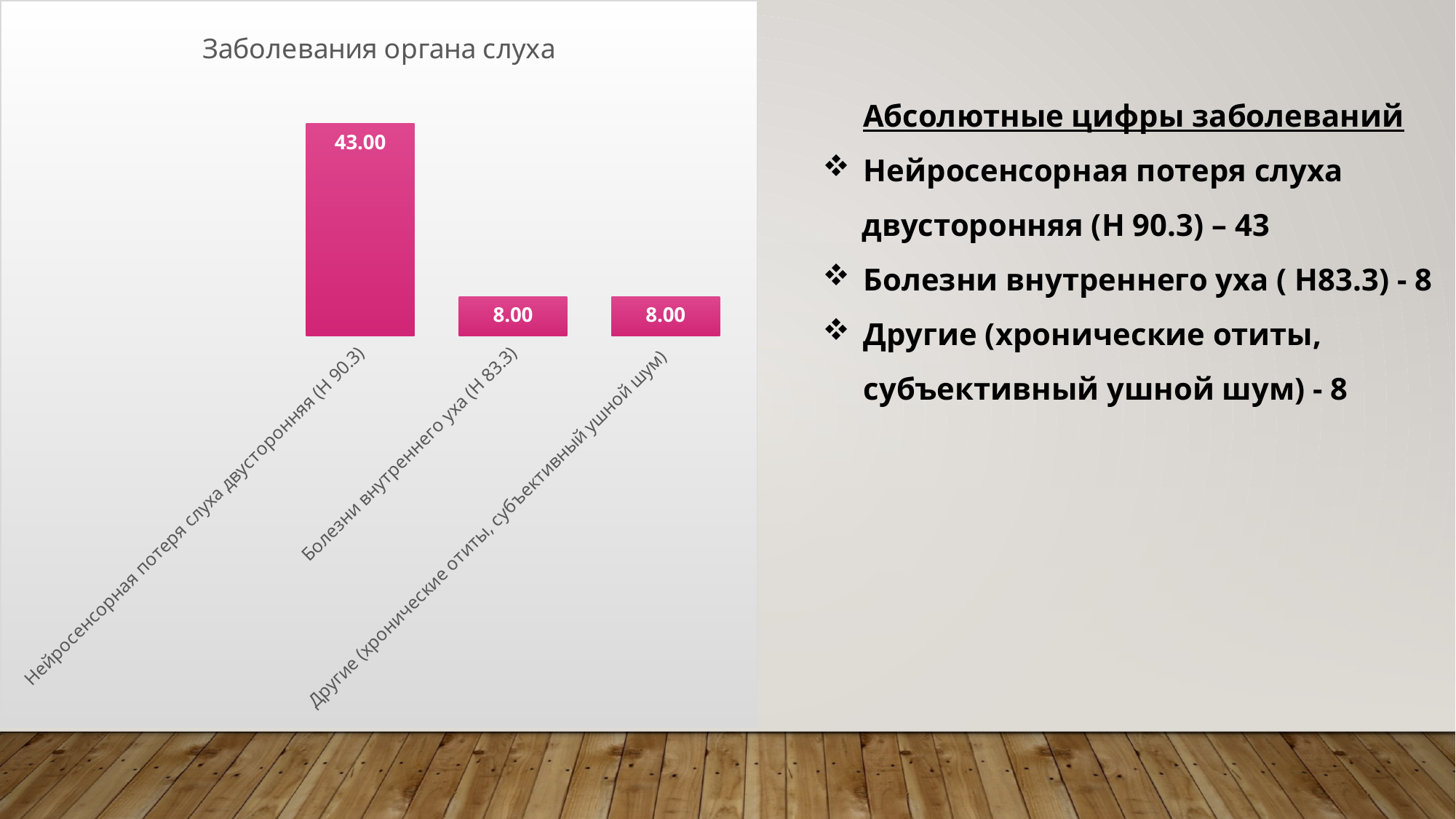
Which is larger: the value for Нейросенсорная потеря слуха двусторонняя (H 90.3) or the value for Другие (хронические отиты, субъективный ушной шум)? Нейросенсорная потеря слуха двусторонняя (H 90.3) What kind of chart is shown on the slide? Bar chart What is the value for Болезни внутреннего уха (H 83.3)? 8.00 What is the value for Нейросенсорная потеря слуха двусторонняя (H 90.3)? 43.00 Do the values for Болезни внутреннего уха (H 83.3) and Другие (хронические отиты, субъективный ушной шум) have the same value? Yes, both are 8.00 What is the value for Другие (хронические отиты, субъективный ушной шум)? 8.00 How many categories are shown in the chart? 3 Which category has the highest value? Нейросенсорная потеря слуха двусторонняя (H 90.3) What is the difference between the values for Нейросенсорная потеря слуха двусторонняя (H 90.3) and Болезни внутреннего уха (H 83.3)? 35.00 What colour are the bars in the chart? Pink (magenta) What is the title of the chart? Заболевания органа слуха